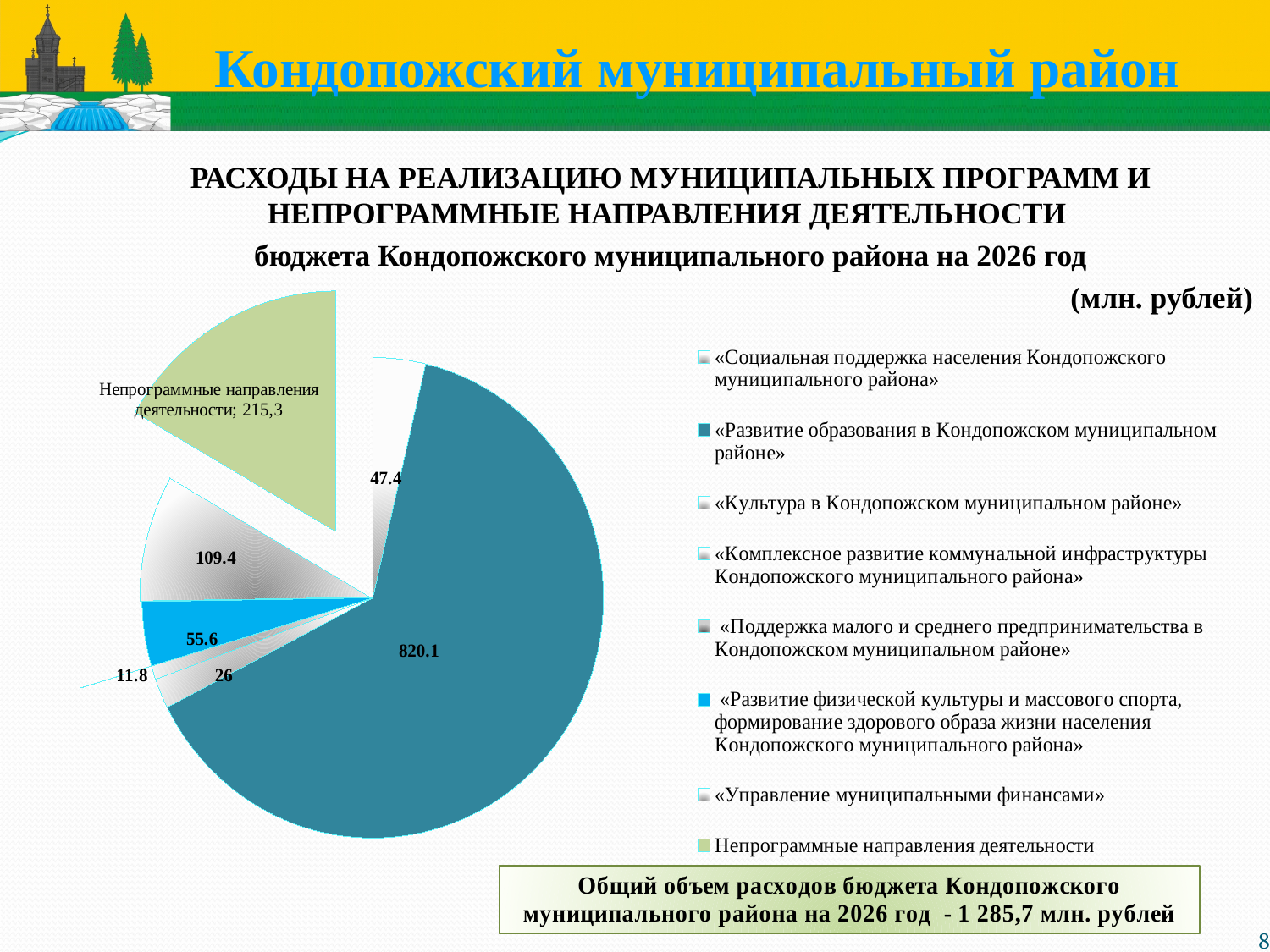
What is the value for «Развитие образования в Кондопожском муниципальном районе» (the teal slice) in the pie chart? 820.1 What is the value for «Развитие физической культуры и массового спорта, формирование здорового образа жизни населения Кондопожского муниципального района» (the blue slice)? 55.6 What is the difference between the value for «Развитие образования в Кондопожском муниципальном районе» (820.1) and the value for «Непрограммные направления деятельности» (215,3)? 604.8 Which is larger: the slice for «Непрограммные направления деятельности» or the slice for «Развитие физической культуры и массового спорта...»? «Непрограммные направления деятельности» Which category has the largest slice in the pie chart? «Развитие образования в Кондопожском муниципальном районе» What is the total budget expenditure for 2026 stated in the box below the chart? 1 285,7 млн. рублей For which year does the chart show the budget expenditures of the Kondopoga municipal district? 2026 What is the value for «Непрограммные направления деятельности» in the pie chart? 215,3 How many data series does the pie chart show? 1 In what units are the values of the pie chart given? млн. рублей What kind of chart is shown on the slide? pie chart How many categories does the legend of the pie chart list? 8